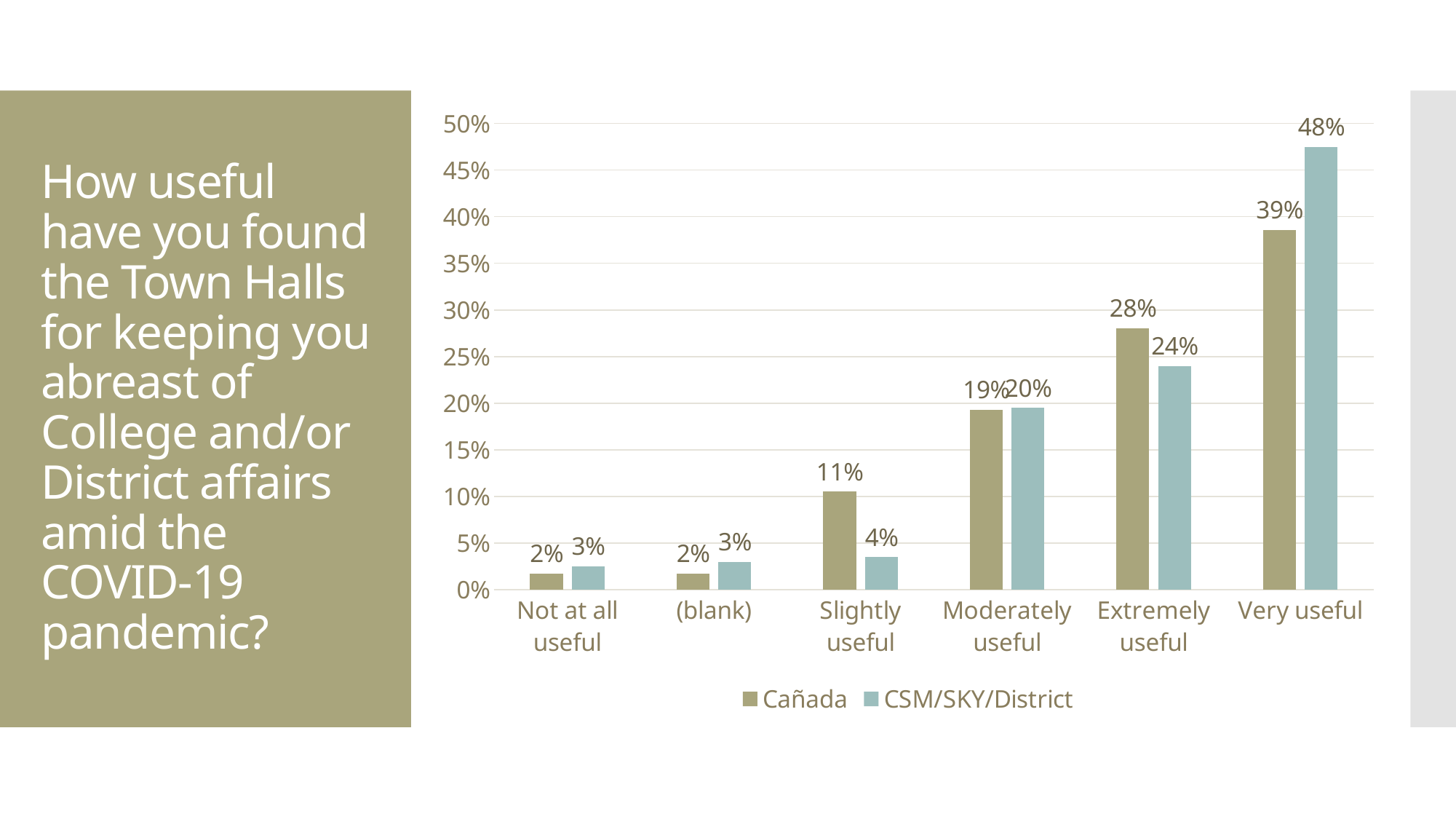
What is the value for Cañada in the Slightly useful category? 11% How many series does the legend list? 2 What is the value for CSM/SKY/District in the Extremely useful category? 24% What kind of chart is shown on the slide? Bar chart How many categories are shown on the x axis? 6 Is the value for CSM/SKY/District in the Very useful category greater or less than 45%? greater What is the difference between Cañada and CSM/SKY/District in the Slightly useful category? 7% In the Extremely useful category, which series has the larger value, Cañada or CSM/SKY/District? Cañada What is the difference between CSM/SKY/District and Cañada in the Very useful category? 9% Which category has the lowest value for CSM/SKY/District? Not at all useful and (blank) (both 3%) Which category has the highest value for CSM/SKY/District? Very useful What is the value for Cañada in the Very useful category? 39%